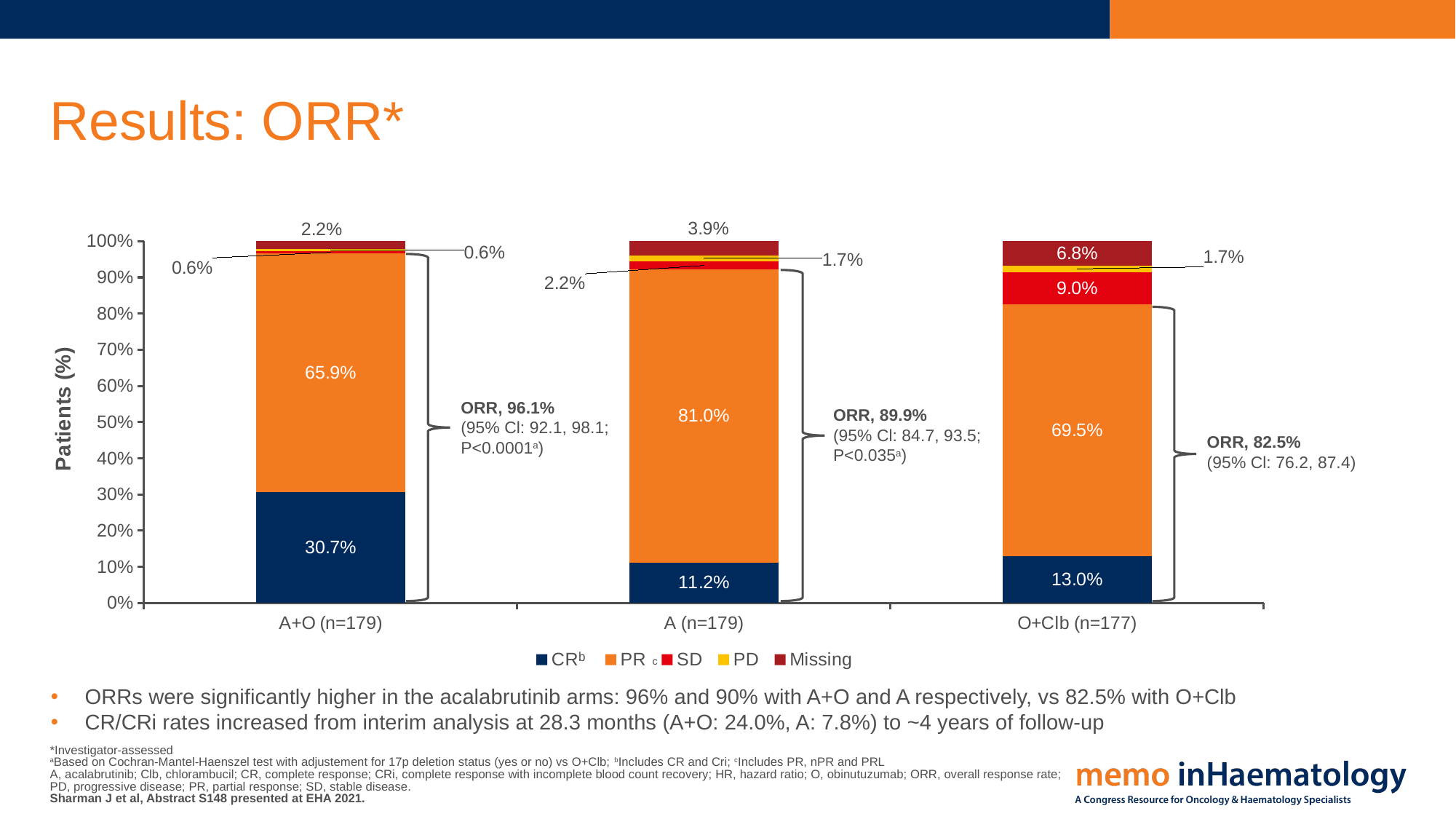
What kind of chart is shown on the slide? Stacked bar chart What is the Missing value for O+Clb (n=177)? 6.8% Which arm has the larger SD value, A (n=179) or O+Clb (n=177)? O+Clb (n=177) Which treatment arm has the lowest CR value? A (n=179) How much higher is the PR value for A (n=179) than for A+O (n=179)? 15.1% What is the CR value for A+O (n=179)? 30.7% What is the PR value for A (n=179)? 81.0% What is the difference between the CR value for A+O (n=179) and the CR value for O+Clb (n=177)? 17.7% What is the SD value for O+Clb (n=177)? 9.0% Which treatment arm has the highest CR value? A+O (n=179) How many series does the legend list? 5 How many treatment arms are shown on the x axis? 3